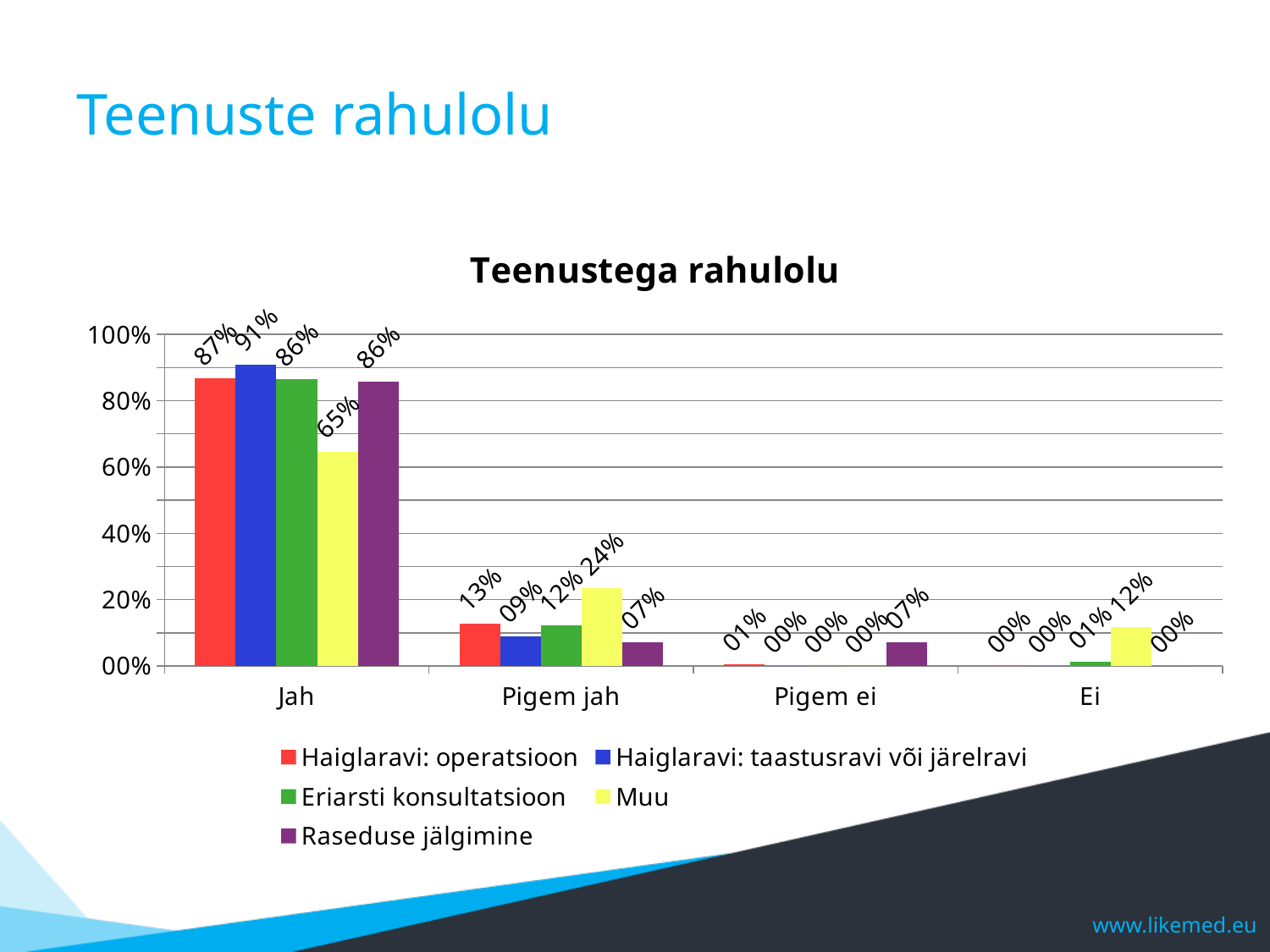
In the Pigem jah category, which is larger: Haiglaravi: operatsioon or Eriarsti konsultatsioon? Haiglaravi: operatsioon Which series has the highest value in the Jah category? Haiglaravi: taastusravi või järelravi What kind of chart is shown? Bar chart Which series has the lowest value in the Jah category? Muu How many categories are shown on the x axis? 4 How many series does the legend list? 5 What is the title of the chart? Teenustega rahulolu What is the value for Muu in the Pigem jah category? 24% What is the value for Haiglaravi: taastusravi või järelravi in the Jah category? 91% What is the value for Muu in the Ei category? 12% What is the value for Raseduse jälgimine in the Pigem ei category? 07% What is the difference between the Haiglaravi: operatsioon value and the Muu value in the Jah category? 22%